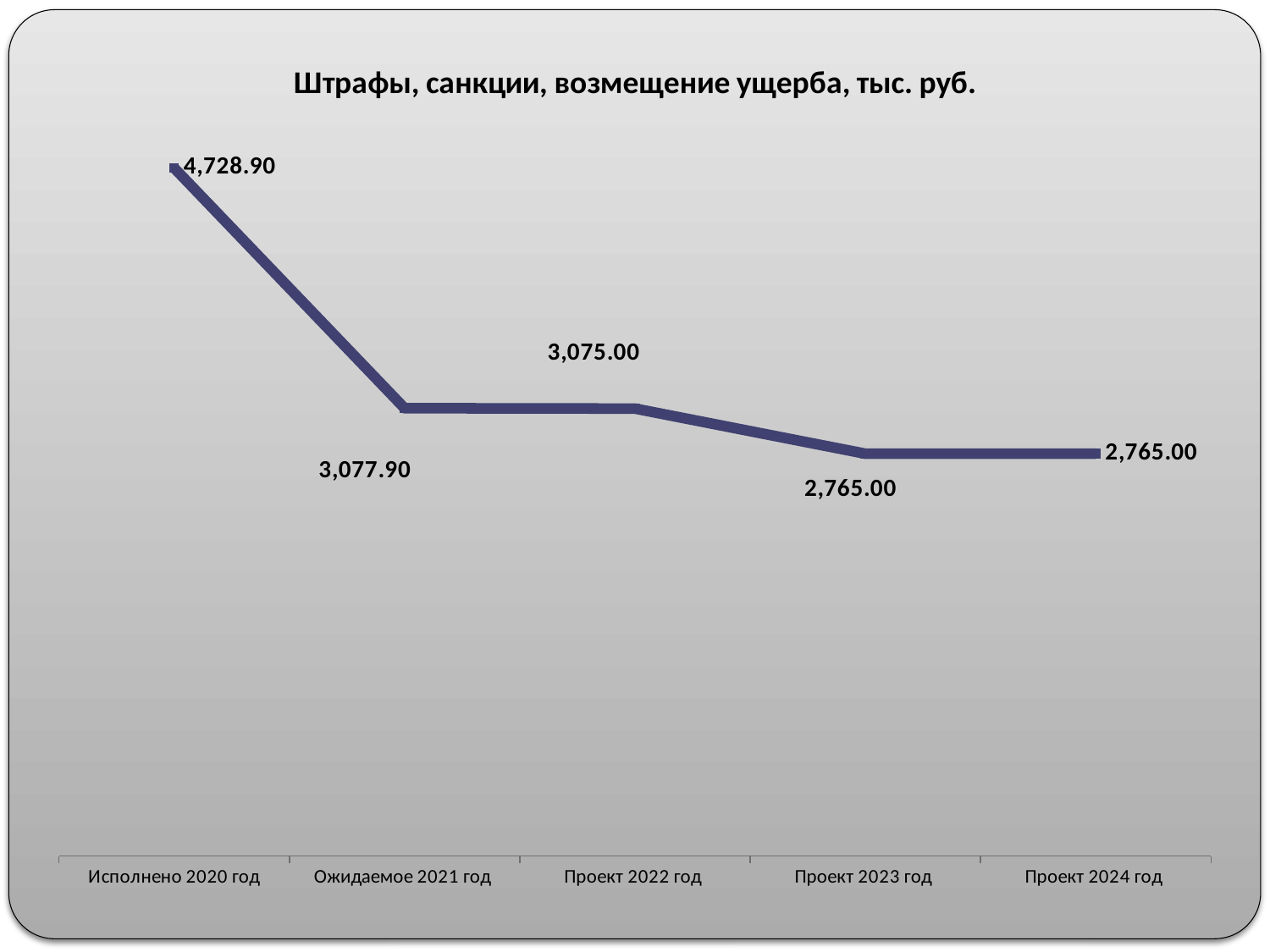
Which is larger, the value for Исполнено 2020 год or the value for Проект 2023 год? Исполнено 2020 год What is the value for Проект 2023 год? 2,765.00 What is the value for Проект 2022 год? 3,075.00 What is the value for Исполнено 2020 год? 4,728.90 How many data points are plotted on the chart? 5 What is the title of the chart? Штрафы, санкции, возмещение ущерба, тыс. руб. What is the difference between the values for Исполнено 2020 год and Ожидаемое 2021 год? 1,651.00 Which category has the highest value? Исполнено 2020 год What is the lowest value shown on the chart? 2,765.00 What type of chart is shown on the slide? Line chart What is the value for Ожидаемое 2021 год? 3,077.90 What is the value for Проект 2024 год? 2,765.00